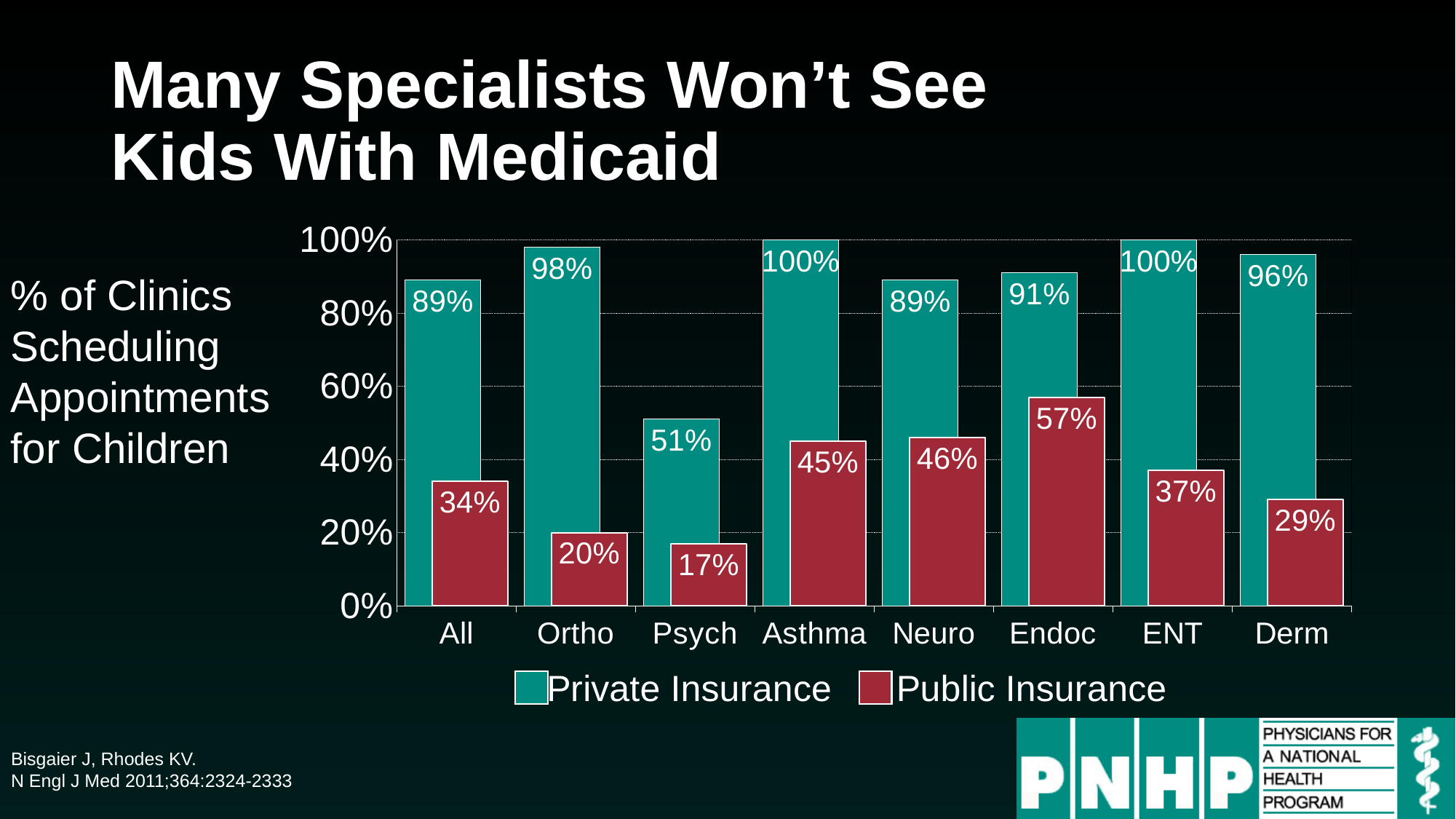
What is the Public Insurance value for Derm? 29% How many series does the legend list? 2 Which category has the highest Public Insurance value? Endoc Which category has the lowest Public Insurance value? Psych What colour are the Public Insurance bars? Red Which category has the lowest Private Insurance value? Psych What kind of chart is shown on the slide? Bar chart What is the Private Insurance value for Psych? 51% What is the Public Insurance value for Endoc? 57% Which is larger for ENT: the Private Insurance value or the Public Insurance value? Private Insurance How many categories are shown on the x axis? 8 What is the difference between the Private Insurance and Public Insurance values for Ortho? 78%